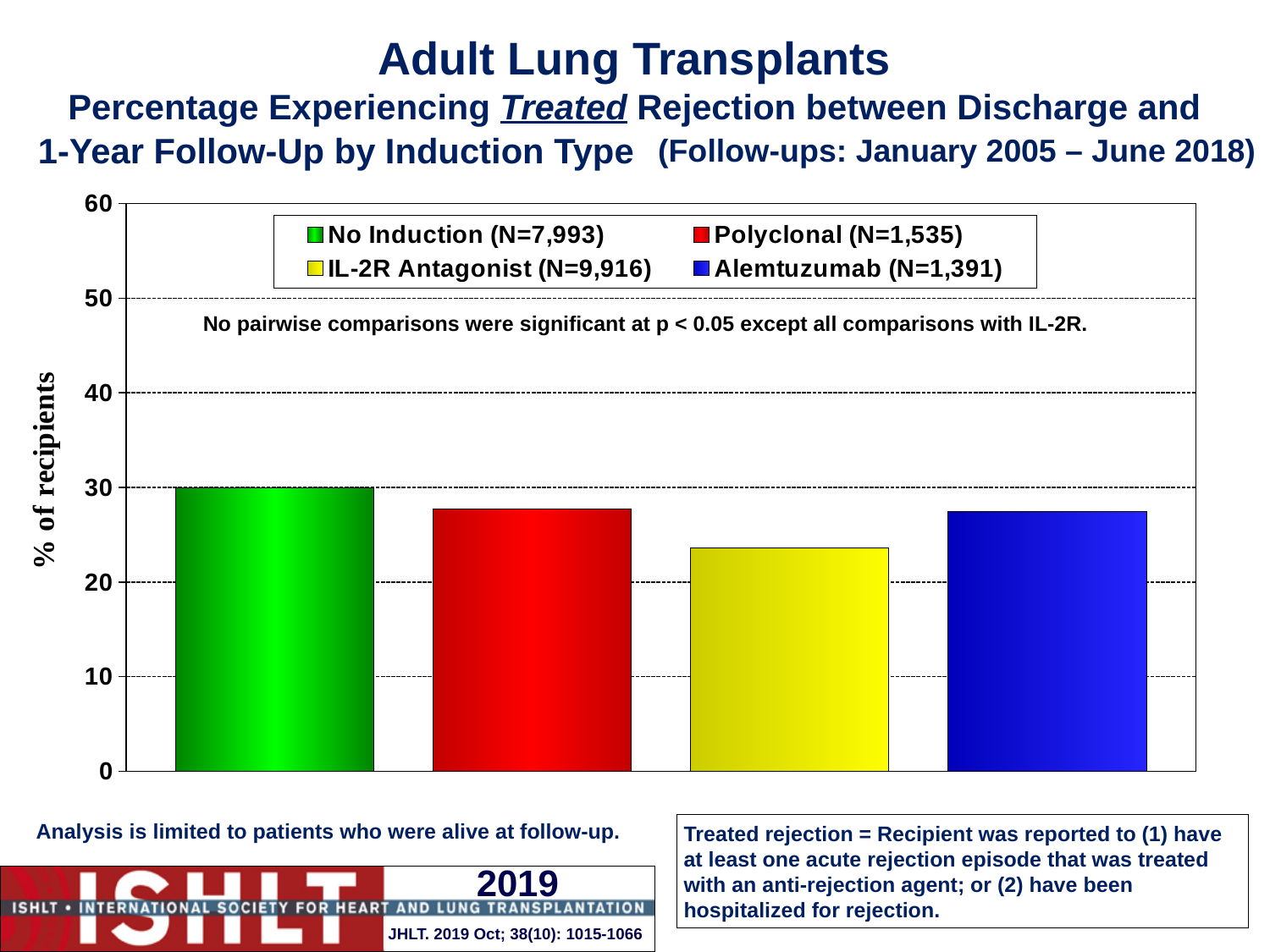
Is the value for Polyclonal greater or less than 20? greater Is the value for Alemtuzumab greater or less than 30? less How many bars are plotted in the chart? 4 How many induction types does the legend list? 4 Which induction type has the highest percentage of recipients with treated rejection? No Induction Which induction type has the lowest percentage of recipients with treated rejection? IL-2R Antagonist Which is larger, the value for No Induction or the value for IL-2R Antagonist? No Induction Which is larger, the value for Polyclonal or the value for IL-2R Antagonist? Polyclonal What colour is the bar for Alemtuzumab? blue Is the value for IL-2R Antagonist greater or less than 30? less What is the N shown in the legend for the IL-2R Antagonist group? 9,916 What kind of chart is shown on the slide? bar chart